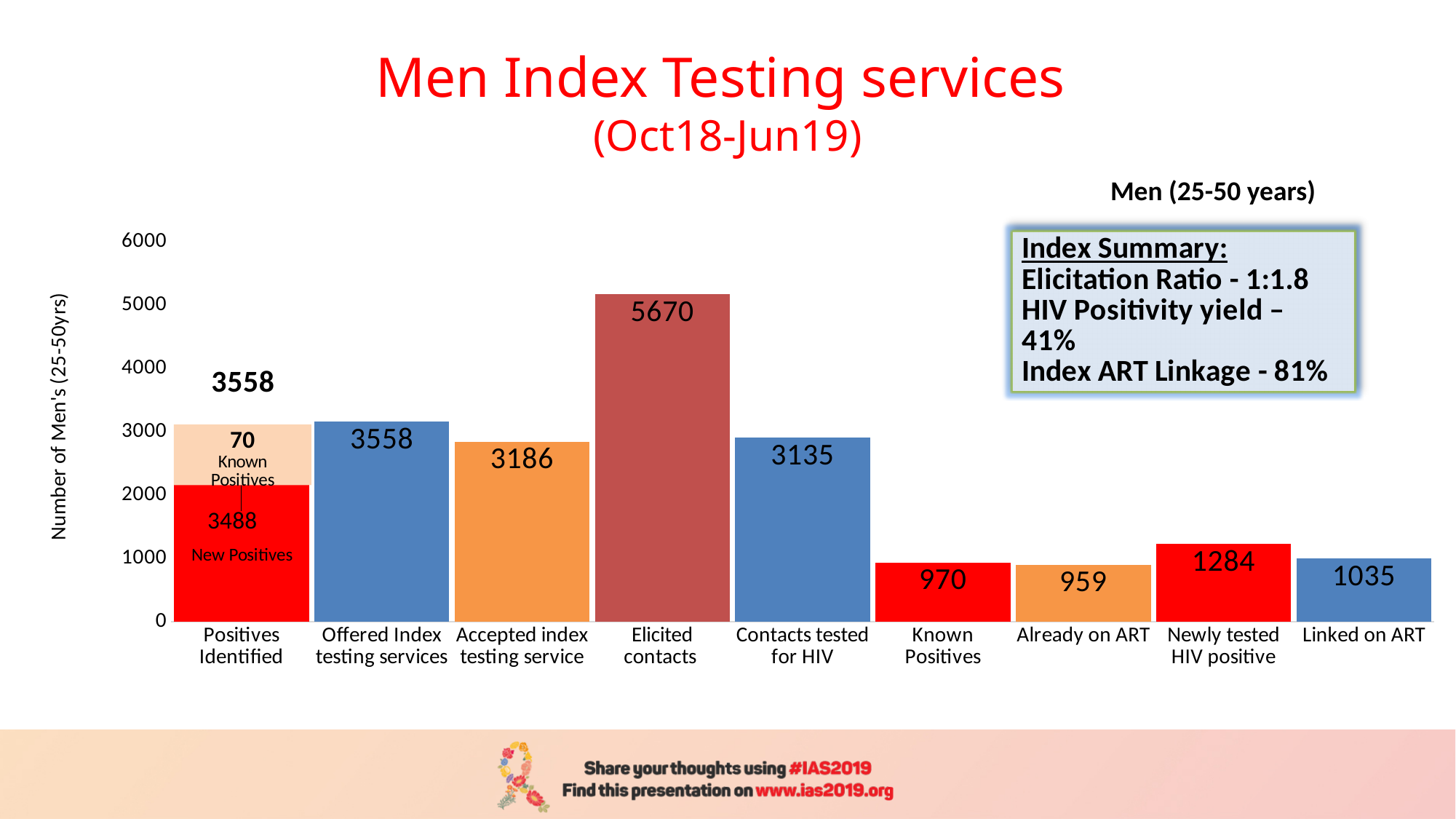
What is the value for Contacts tested for HIV? 3135 How many New Positives are shown in the Positives Identified bar? 3488 What is the value for Elicited contacts? 5670 How many categories are shown on the x axis? 9 How many Known Positives are shown in the Positives Identified bar? 70 What is the total of the stacked Positives Identified bar? 3558 What is the difference between Elicited contacts and Contacts tested for HIV? 2535 What is the difference between Newly tested HIV positive and Linked on ART? 249 Which category has the highest value? Elicited contacts Which category has the lowest value? Already on ART Which is larger, Offered Index testing services or Accepted index testing service? Offered Index testing services What is the value for Newly tested HIV positive? 1284